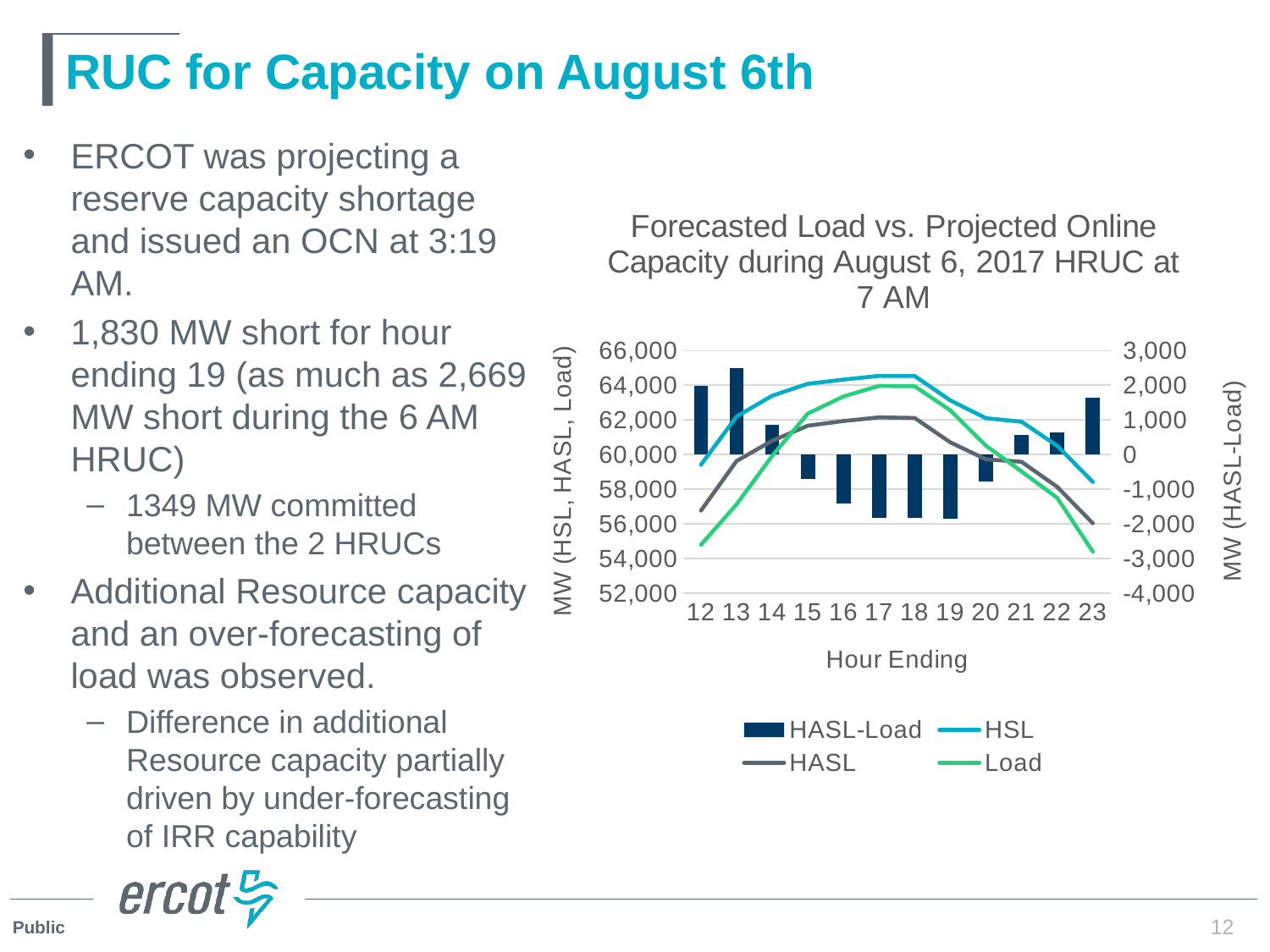
At which hour ending is the HASL-Load bar the highest? 13 At hour ending 12, which is higher, HSL or Load? HSL Is the Load value for hour ending 12 greater or less than 56,000? less What kind of chart is shown on the slide? A combination bar and line chart How many series does the chart legend list? 4 Is the HASL-Load value for hour ending 17 greater or less than -1,000? less What is the x-axis title of the chart? Hour Ending How many hour-ending categories are shown on the x axis of the chart? 12 Which series is plotted as bars in the chart? HASL-Load Is the HASL-Load value for hour ending 13 greater or less than 2,000? greater Does the Load line rise or fall from hour ending 12 to hour ending 17? rise